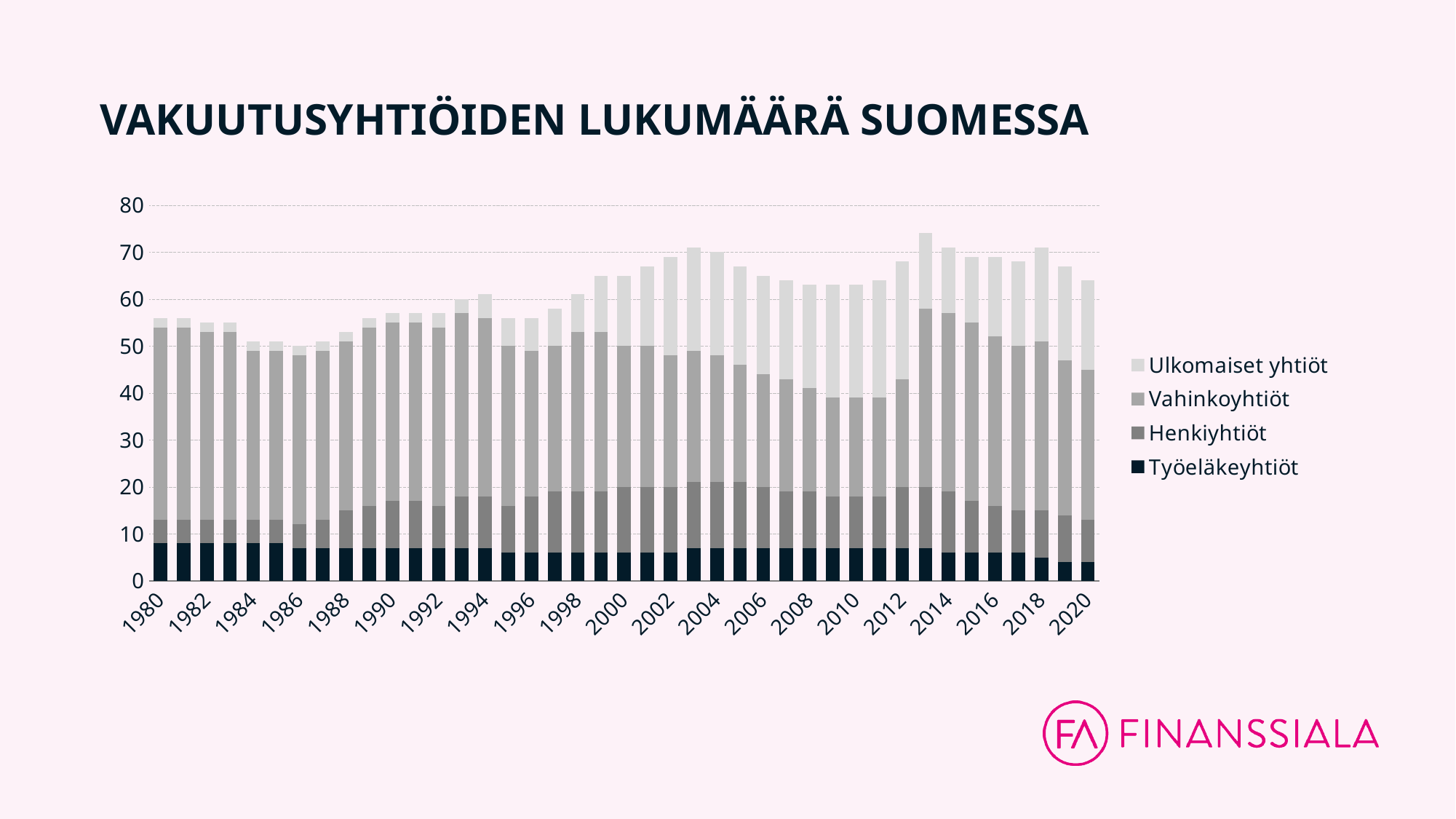
Does the Työeläkeyhtiöt segment rise or fall from 1980 to 2020? fall Is the value for Työeläkeyhtiöt in 1980 greater or less than 10? less Which year has the tallest stacked bar (highest total)? 2013 How many series does the legend list? 4 Is the total for 2020 greater or less than 60? greater Which year has the larger total, 2013 or 1986? 2013 What kind of chart is shown on the slide? Stacked bar chart Which series is shown at the bottom of each stacked bar, in the darkest colour? Työeläkeyhtiöt What is the title of the chart? VAKUUTUSYHTIÖIDEN LUKUMÄÄRÄ SUOMESSA Is the total for 1986 greater or less than 60? less Does the Ulkomaiset yhtiöt segment rise or fall from 1980 to 2020? rise